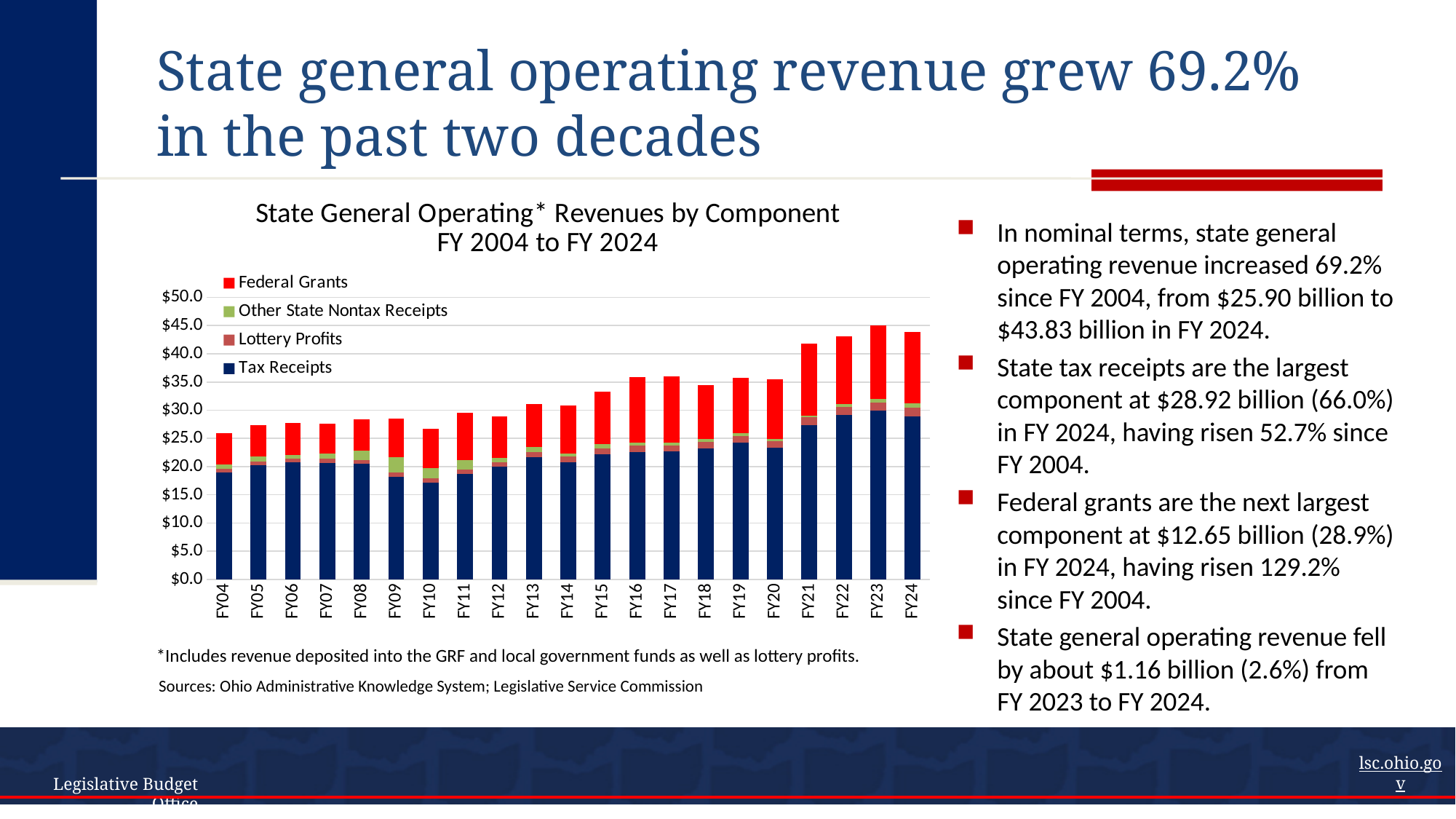
Is the Tax Receipts segment for FY10 greater or less than $20.0? less Is the Tax Receipts segment for FY22 greater or less than $25.0? greater Which has the larger total bar, FY20 or FY21? FY21 How many fiscal years are plotted along the x axis of the chart? 21 What is the title of the chart? State General Operating* Revenues by Component FY 2004 to FY 2024 How many series does the chart legend list? 4 Which fiscal year has the tallest total bar in the chart? FY23 Is the total bar for FY10 greater or less than $30.0? less Overall, do the total bars rise or fall from FY04 to FY24? Rise What colour represents Federal Grants in the chart? Red What kind of chart is shown on the slide? Stacked bar chart